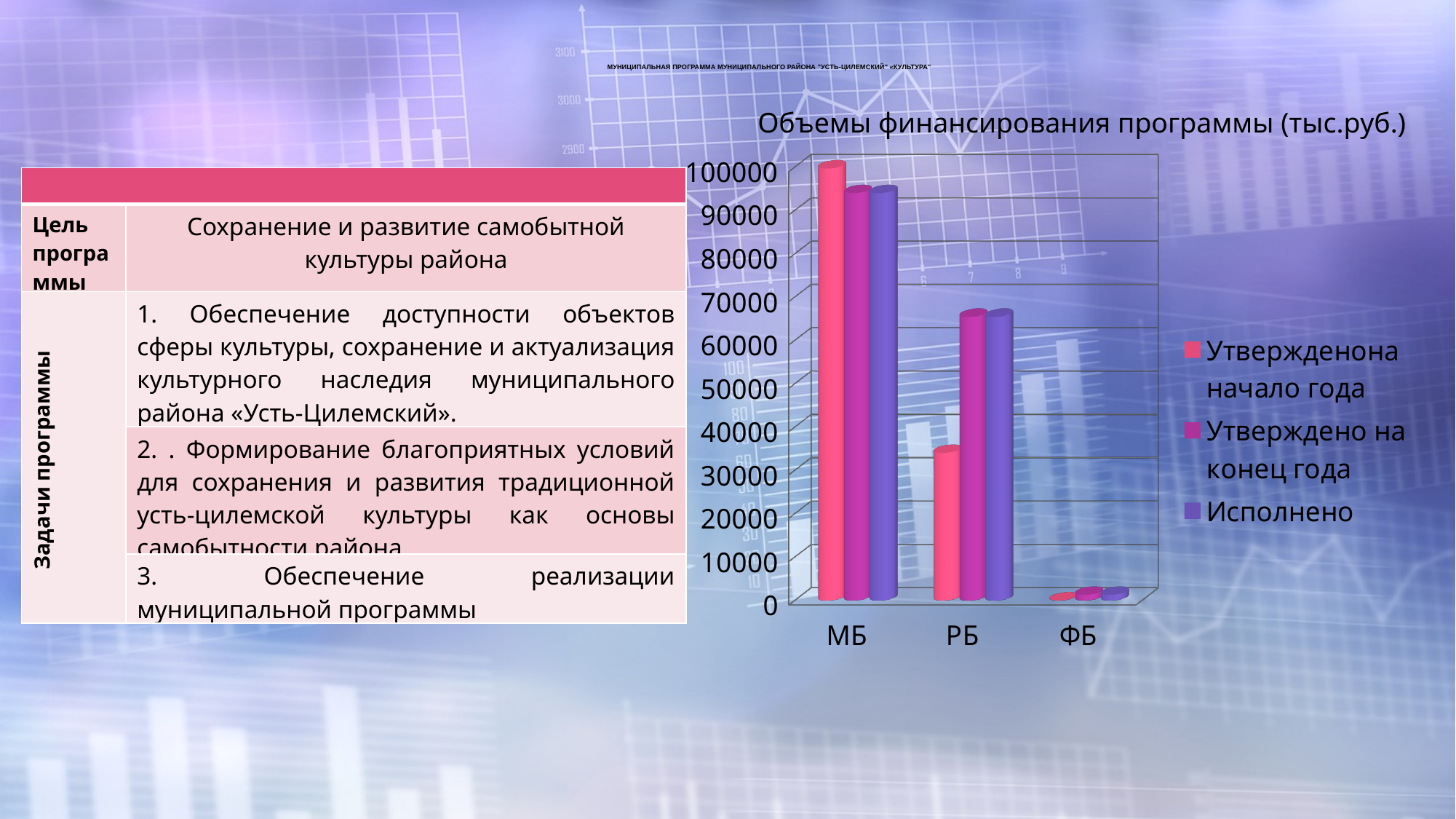
Is the value for РБ in the series 'Утверждено на начало года' greater or less than 40000? less Is the value for МБ in the series 'Утверждено на начало года' greater or less than 90000? greater Is the value for РБ in the series 'Исполнено' greater or less than 60000? greater Which category has the lowest values across all series? ФБ For the series 'Утверждено на начало года', which is larger: МБ or РБ? МБ For the category РБ, which is larger: 'Утверждено на начало года' or 'Утверждено на конец года'? Утверждено на конец года Which category has the highest value for the series 'Утверждено на начало года'? МБ How many categories are shown on the x axis of the chart? 3 How many series does the chart legend list? 3 Which series is listed last in the chart legend? Исполнено What kind of chart is shown on the slide? bar chart What is the title of the chart? Объемы финансирования программы (тыс.руб.)